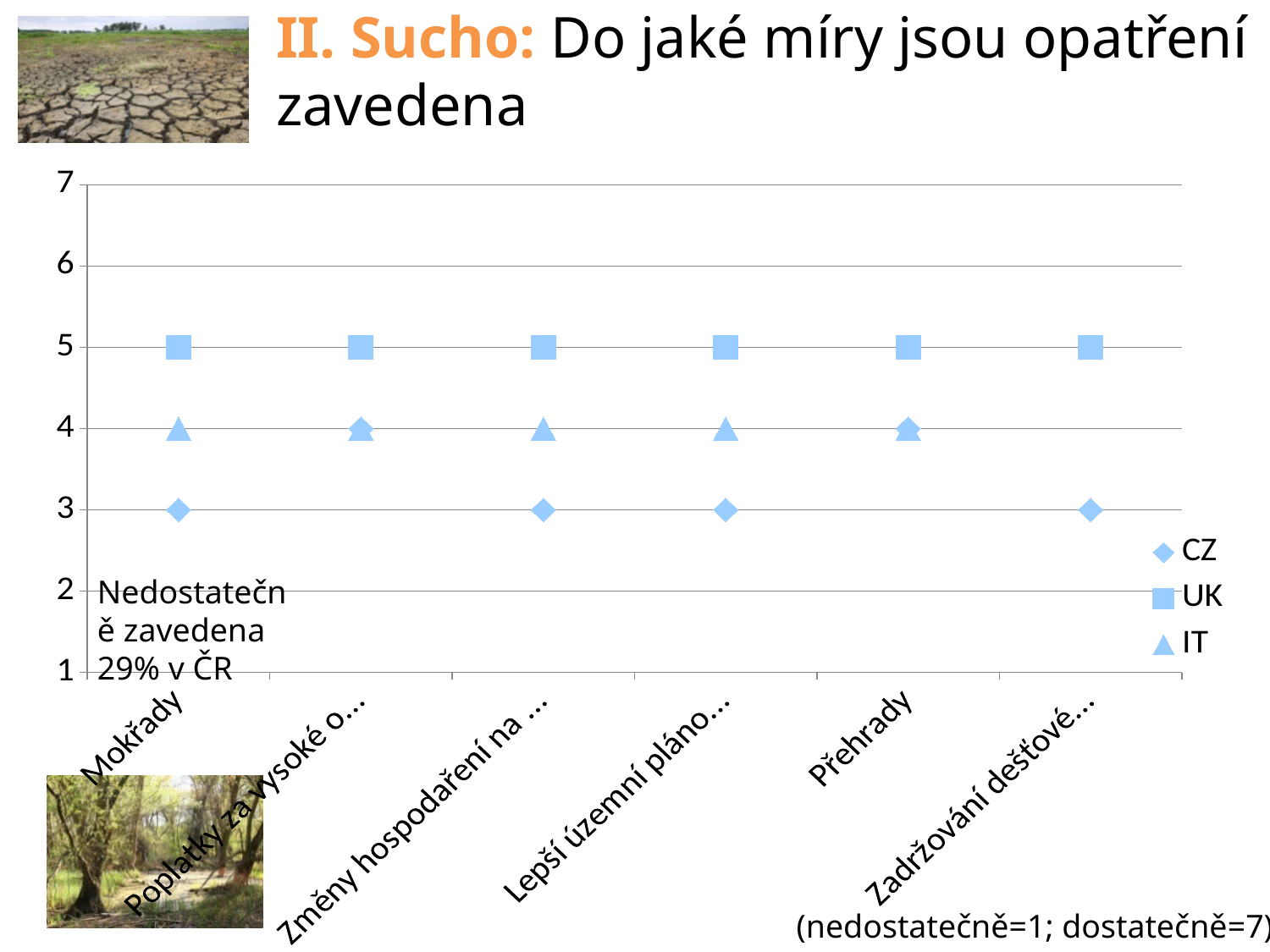
How many categories are shown on the x axis? 6 Is the value for UK for Přehrady greater or less than 4? greater What is the value for UK for Mokřady? 5 What is the value for IT for Přehrady? 4 Which series has the lowest value for Mokřady? CZ What is the difference between the UK and CZ values for Mokřady? 2 What is the value for CZ for Mokřady? 3 What kind of chart is this? scatter chart Which series has the highest value for Mokřady? UK What is the value for CZ for Přehrady? 4 How many series does the legend list? 3 For Přehrady, which is larger: the UK value or the IT value? UK